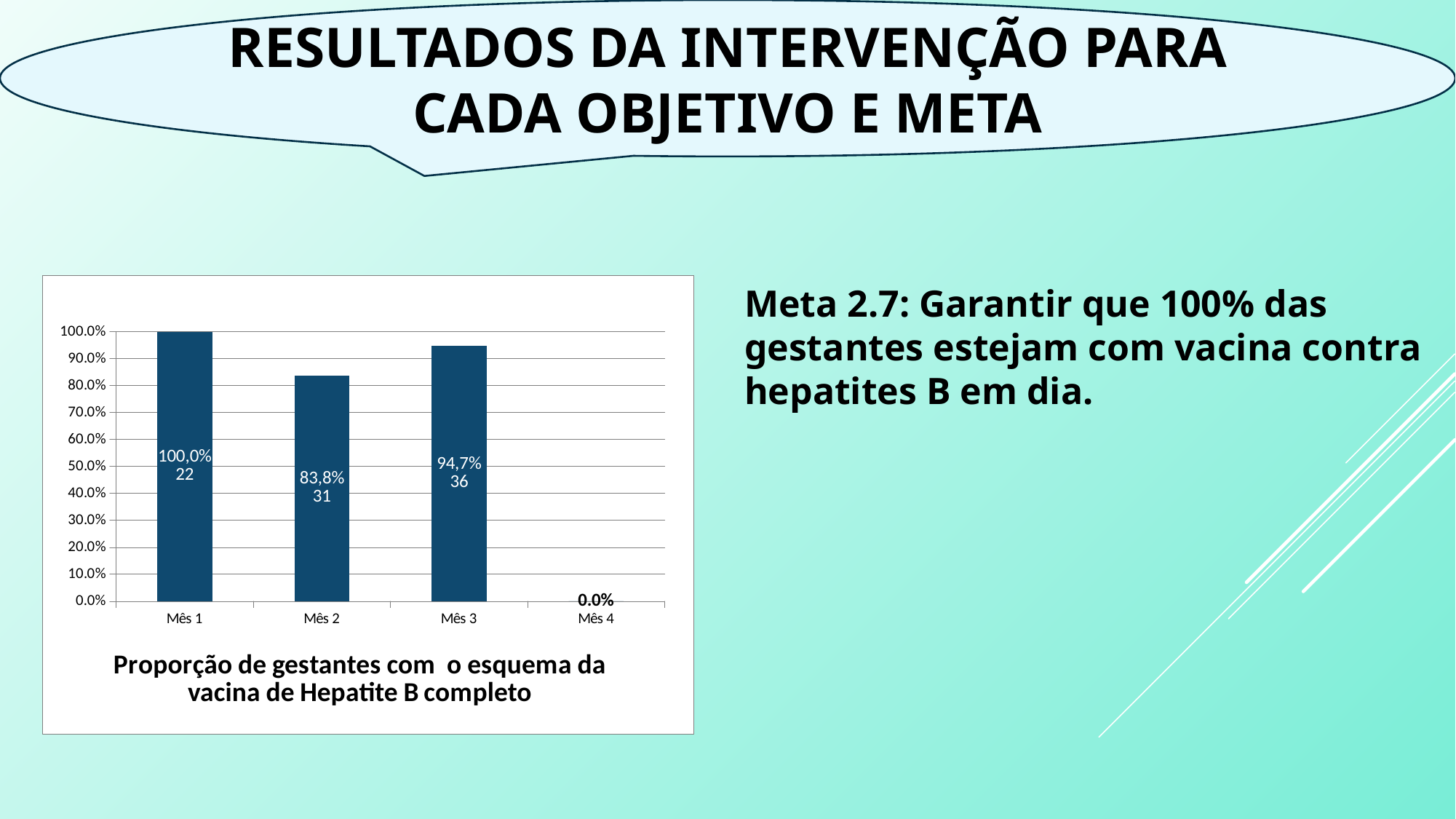
What kind of chart is shown on the slide? bar chart What is the title of the chart? Proporção de gestantes com o esquema da vacina de Hepatite B completo Which month has the lowest percentage? Mês 4 Is the value for Mês 2 greater or less than 90.0%? less What value is labelled for Mês 4? 0.0% What percentage is shown for Mês 3? 94,7% What percentage is shown for Mês 1? 100,0% What count is printed inside the bar for Mês 3? 36 Which is larger, the percentage for Mês 2 or for Mês 3? Mês 3 Which month has the highest percentage? Mês 1 How many months are shown on the x axis? 4 What percentage is shown for Mês 2? 83,8%